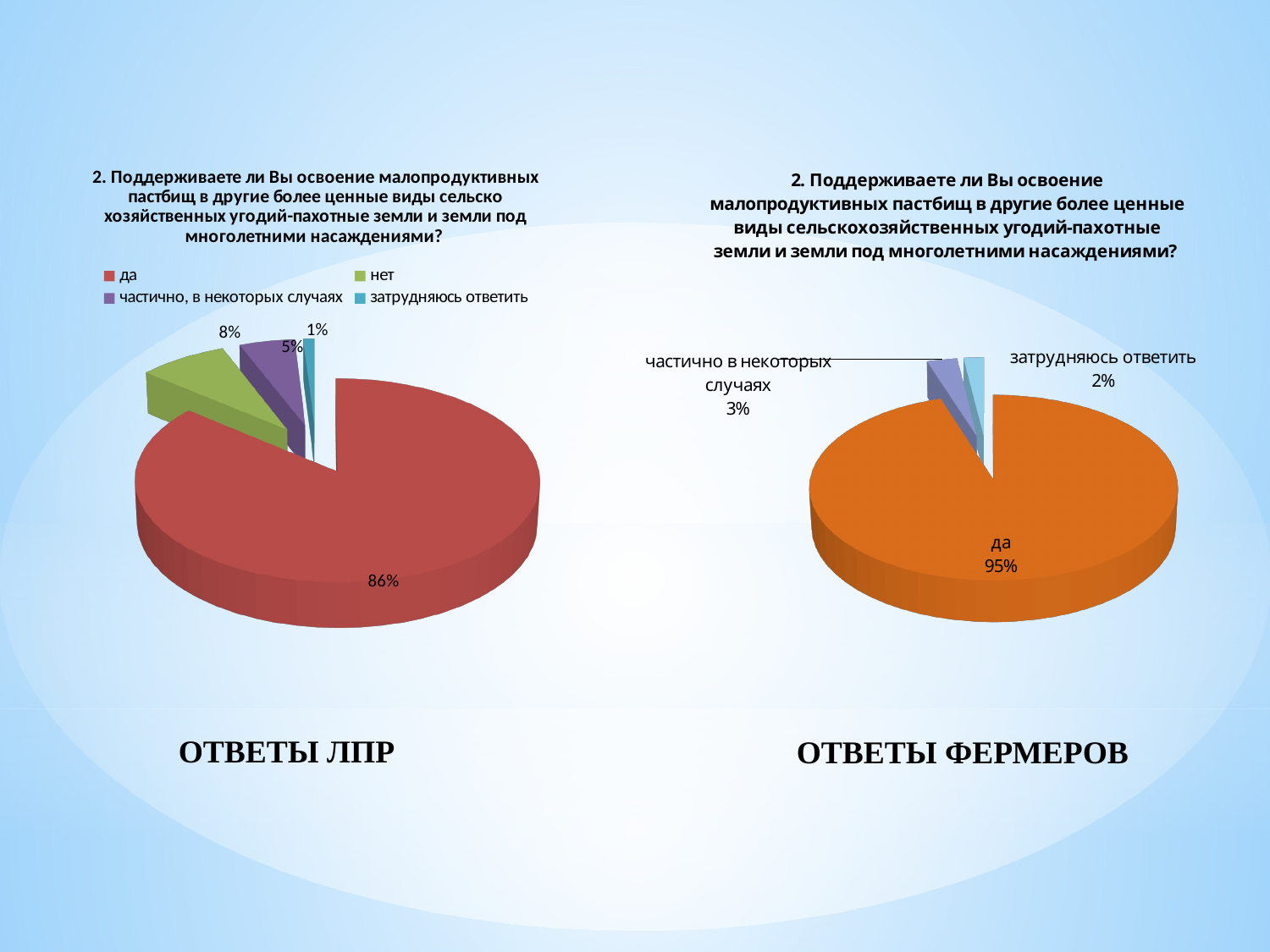
What is the difference between the share answering "да" in the right chart (ОТВЕТЫ ФЕРМЕРОВ) and in the left chart (ОТВЕТЫ ЛПР)? 9 percentage points In the right pie chart (ОТВЕТЫ ФЕРМЕРОВ), which answer has the largest share? да What type of chart is used on this slide? Pie chart In the left pie chart (ОТВЕТЫ ЛПР), what share of respondents answered "да"? 86% In the left pie chart (ОТВЕТЫ ЛПР), what share of respondents answered "затрудняюсь ответить"? 1% In the left pie chart (ОТВЕТЫ ЛПР), what share of respondents answered "частично, в некоторых случаях"? 5% In the right pie chart (ОТВЕТЫ ФЕРМЕРОВ), what share of respondents answered "затрудняюсь ответить"? 2% In the right pie chart (ОТВЕТЫ ФЕРМЕРОВ), what share of respondents answered "да"? 95% In the left pie chart (ОТВЕТЫ ЛПР), which answer has the smallest share? затрудняюсь ответить In the right pie chart (ОТВЕТЫ ФЕРМЕРОВ), what share of respondents answered "частично в некоторых случаях"? 3% How many entries does the legend of the left chart (ОТВЕТЫ ЛПР) list? 4 In the left pie chart (ОТВЕТЫ ЛПР), what share of respondents answered "нет"? 8%